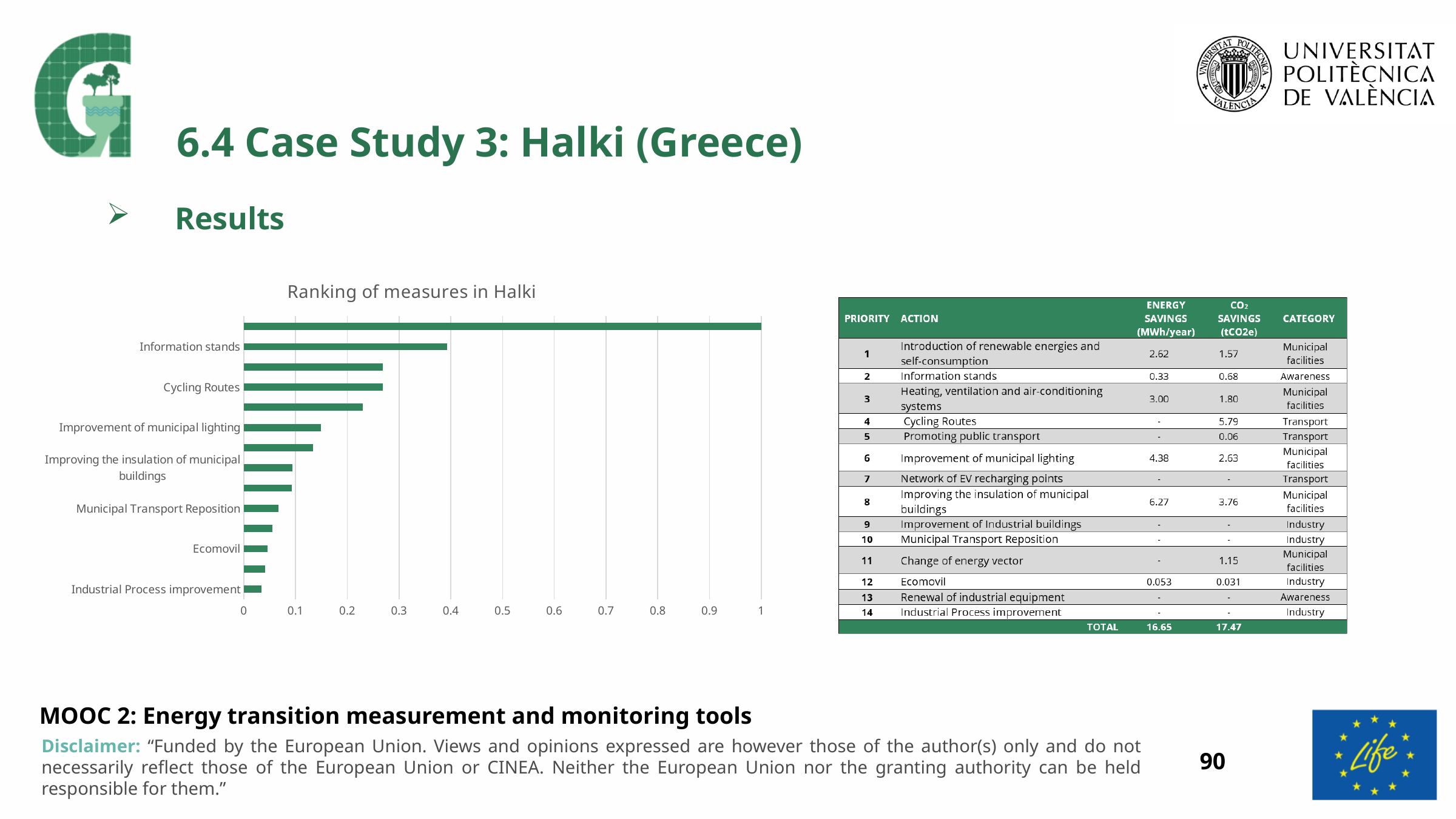
Do the bar values increase or decrease going from the top of the chart to the bottom? decrease Is the value for Improvement of municipal lighting greater or less than 0.1? greater What kind of chart is shown on the slide? bar chart Which has the larger value, Information stands or Cycling Routes? Information stands How many bars are plotted in the chart? 14 Is the value for Cycling Routes greater or less than 0.2? greater Is the value for Cycling Routes greater or less than 0.3? less Which category has the lowest value in the chart? Industrial Process improvement What is the title of the chart on the slide? Ranking of measures in Halki